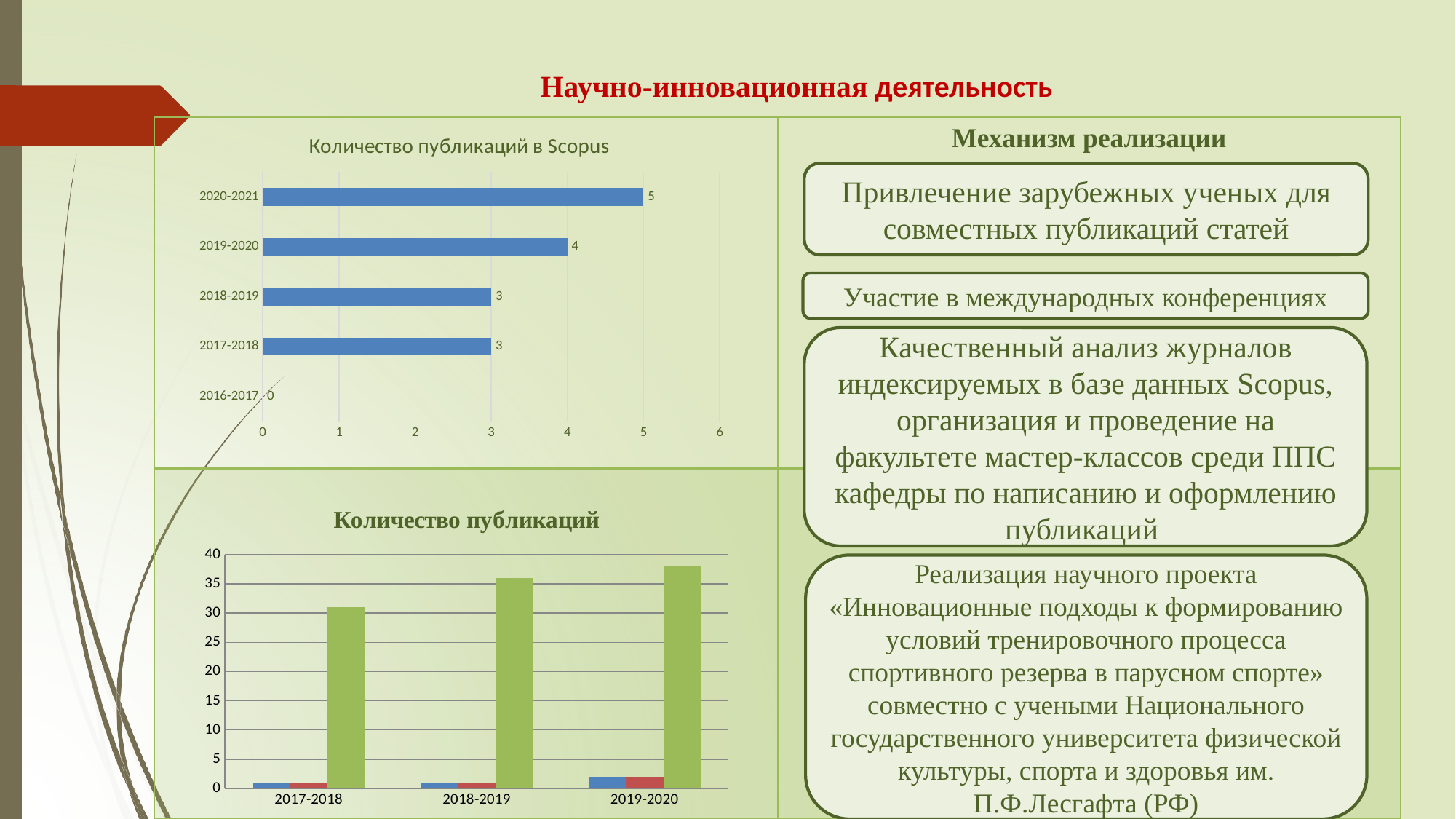
In the chart titled "Количество публикаций", do the green bars rise or fall from 2017-2018 to 2019-2020? Rise In the chart titled "Количество публикаций", is the green bar for 2019-2020 greater or less than 35? greater In the chart titled "Количество публикаций в Scopus", which period has the lowest value? 2016-2017 How many periods are shown on the x axis of the chart titled "Количество публикаций"? 3 In the chart titled "Количество публикаций в Scopus", which period has the highest value? 2020-2021 In the chart titled "Количество публикаций в Scopus", what is the difference between the values for 2020-2021 and 2018-2019? 2 In the chart titled "Количество публикаций в Scopus", what is the value for 2020-2021? 5 How many periods are shown in the chart titled "Количество публикаций в Scopus"? 5 What type of chart is the chart titled "Количество публикаций в Scopus"? Bar chart In the chart titled "Количество публикаций в Scopus", what is the value for 2019-2020? 4 In the chart titled "Количество публикаций в Scopus", which is larger: the value for 2019-2020 or the value for 2017-2018? 2019-2020 In the chart titled "Количество публикаций в Scopus", do the values rise or fall from 2016-2017 to 2020-2021? Rise